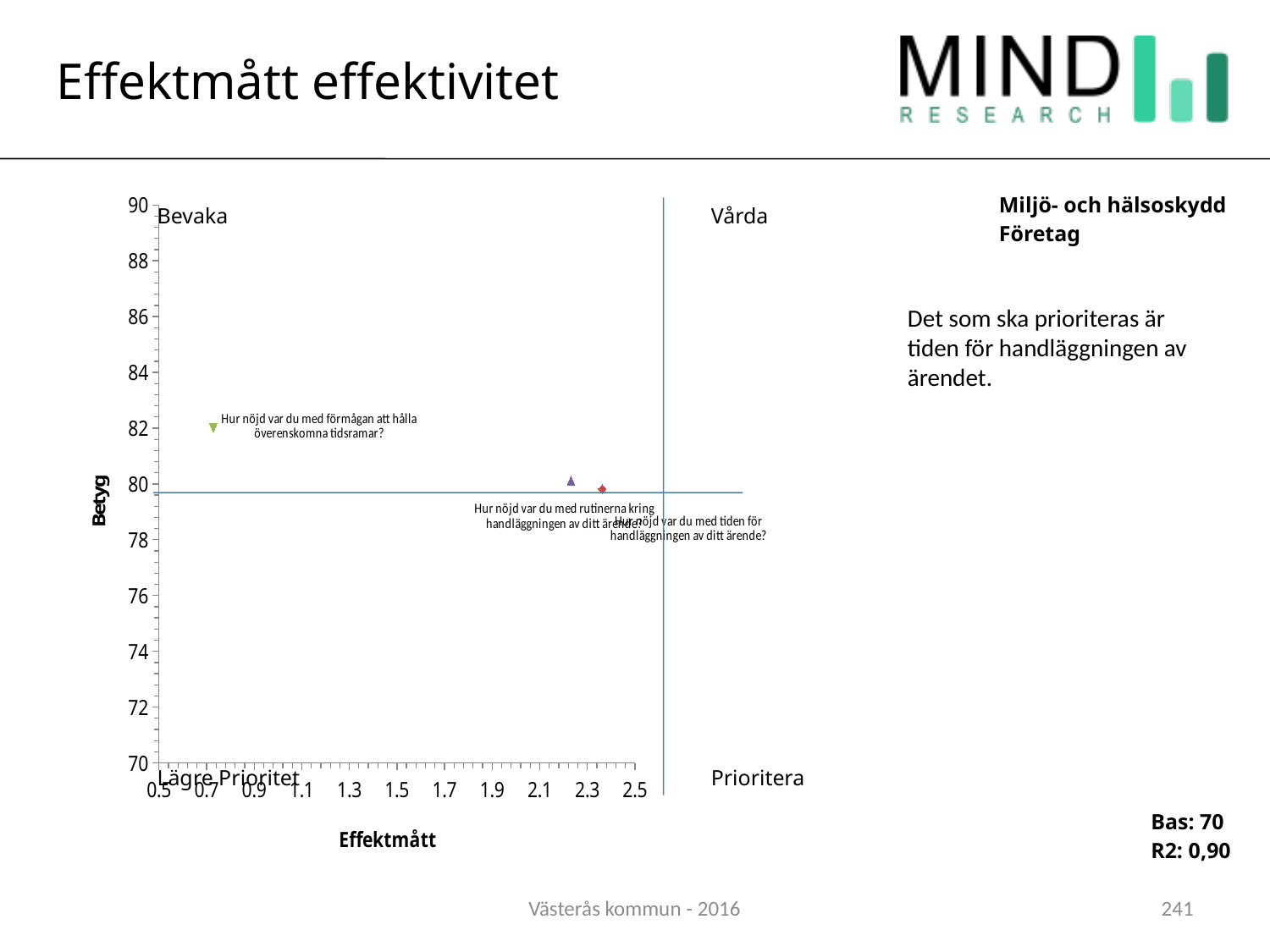
What is the title of the vertical axis of the chart? Betyg How many data points are plotted in the chart? 3 Which has a higher Effektmått value: 'Hur nöjd var du med rutinerna kring handläggningen av ditt ärende?' or 'Hur nöjd var du med förmågan att hålla överenskomna tidsramar?' Hur nöjd var du med rutinerna kring handläggningen av ditt ärende? What kind of chart is shown on the slide? scatter chart Is the Effektmått value for 'Hur nöjd var du med förmågan att hålla överenskomna tidsramar?' greater or less than 1.1? less Is the Betyg value for 'Hur nöjd var du med förmågan att hålla överenskomna tidsramar?' greater or less than 80? greater Which question has the lowest Effektmått value in the chart? Hur nöjd var du med förmågan att hålla överenskomna tidsramar? Which question has the highest Betyg value in the chart? Hur nöjd var du med förmågan att hålla överenskomna tidsramar? Is the Effektmått value for 'Hur nöjd var du med tiden för handläggningen av ditt ärende?' greater or less than 2.1? greater What is the title of the horizontal axis of the chart? Effektmått Which has a higher Betyg value: 'Hur nöjd var du med förmågan att hålla överenskomna tidsramar?' or 'Hur nöjd var du med tiden för handläggningen av ditt ärende?' Hur nöjd var du med förmågan att hålla överenskomna tidsramar?